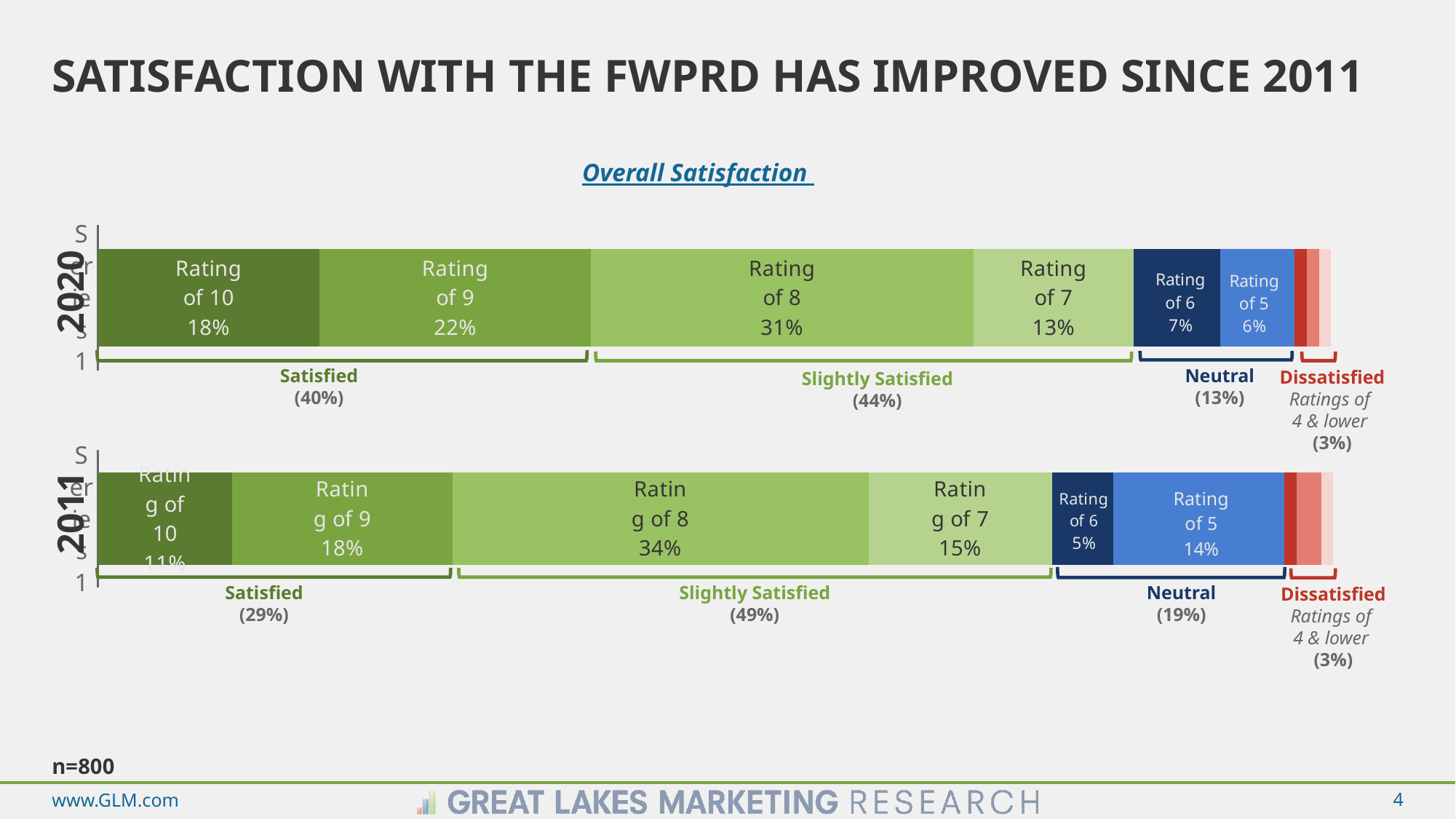
What is the title shown above the charts? Overall Satisfaction In the 2020 chart, which rating has the largest segment? Rating of 8 In the 2020 chart, what percentage gave a rating of 8? 31% What is the Dissatisfied share in the 2011 chart? 3% What is the difference between the Neutral share in 2011 (19%) and in 2020 (13%)? 6% In the 2020 chart, what percentage gave a rating of 9? 22% Which is larger: the rating of 7 share in 2020 or in 2011? 2011 In the 2011 chart, which rating has the smallest labelled segment? Rating of 6 What kind of chart is used to show the 2020 and 2011 satisfaction ratings? Stacked bar chart In the 2011 chart, what percentage gave a rating of 5? 14% In the 2011 chart, what is the Slightly Satisfied share shown under the bracket? 49% In the 2020 chart, what is the combined share of ratings of 10 and 9? 40%